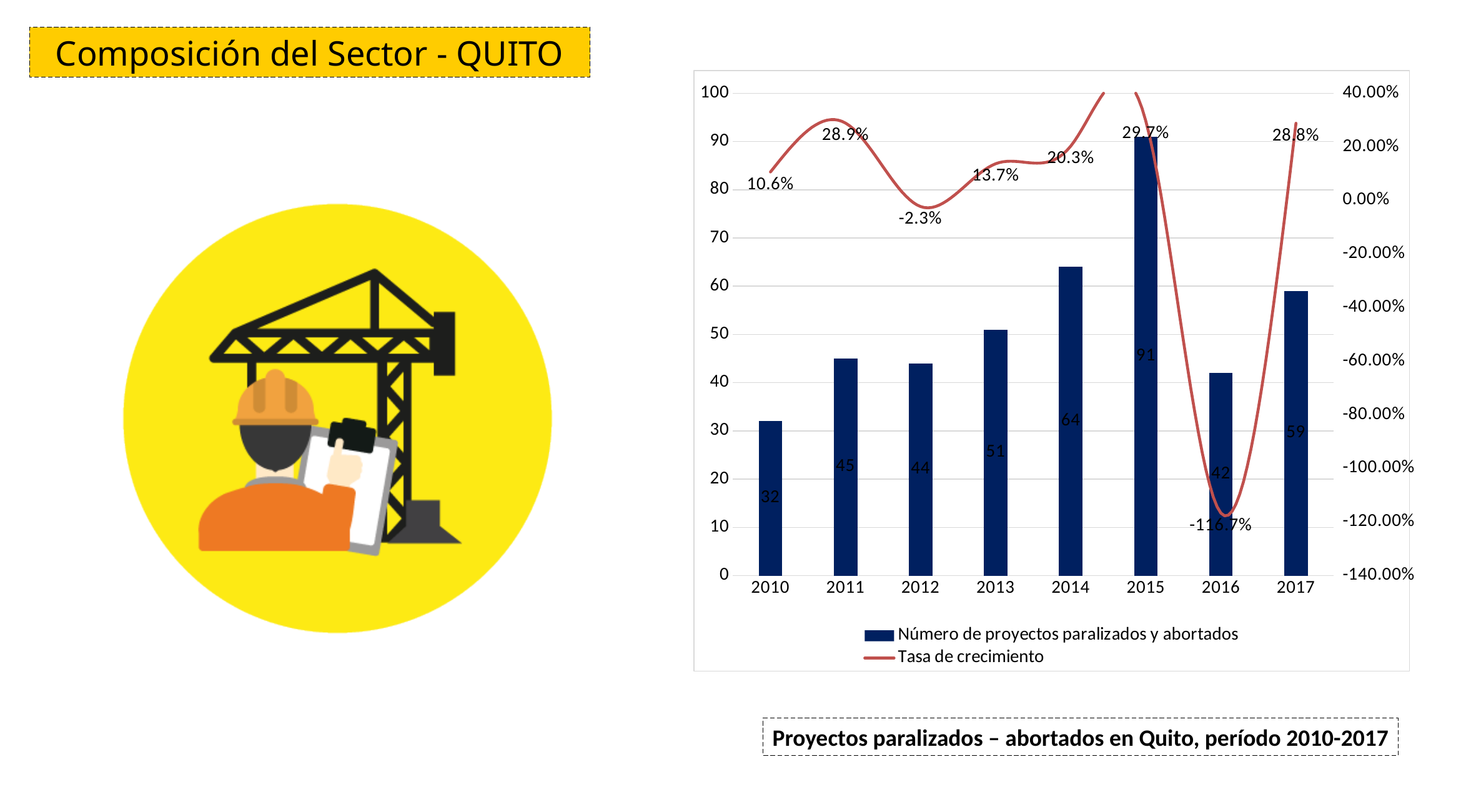
How many paralyzed and aborted projects were there in 2015? 91 What kind of chart is used to show the number of paralyzed and aborted projects? Bar chart Is the number of paralyzed and aborted projects in 2014 greater or less than 60? greater Which year had more paralyzed and aborted projects, 2011 or 2012? 2011 What is the difference in the number of paralyzed and aborted projects between 2015 and 2016? 49 How many years are shown on the x axis of the chart? 8 What was the growth rate (Tasa de crecimiento) in 2016? -116.7% What is the growth rate (Tasa de crecimiento) shown for 2012? -2.3% Did the number of paralyzed and aborted projects rise or fall from 2012 to 2015? Rise Which year had the lowest number of paralyzed and aborted projects? 2010 Which year had the highest number of paralyzed and aborted projects? 2015 How many series does the chart legend list? 2